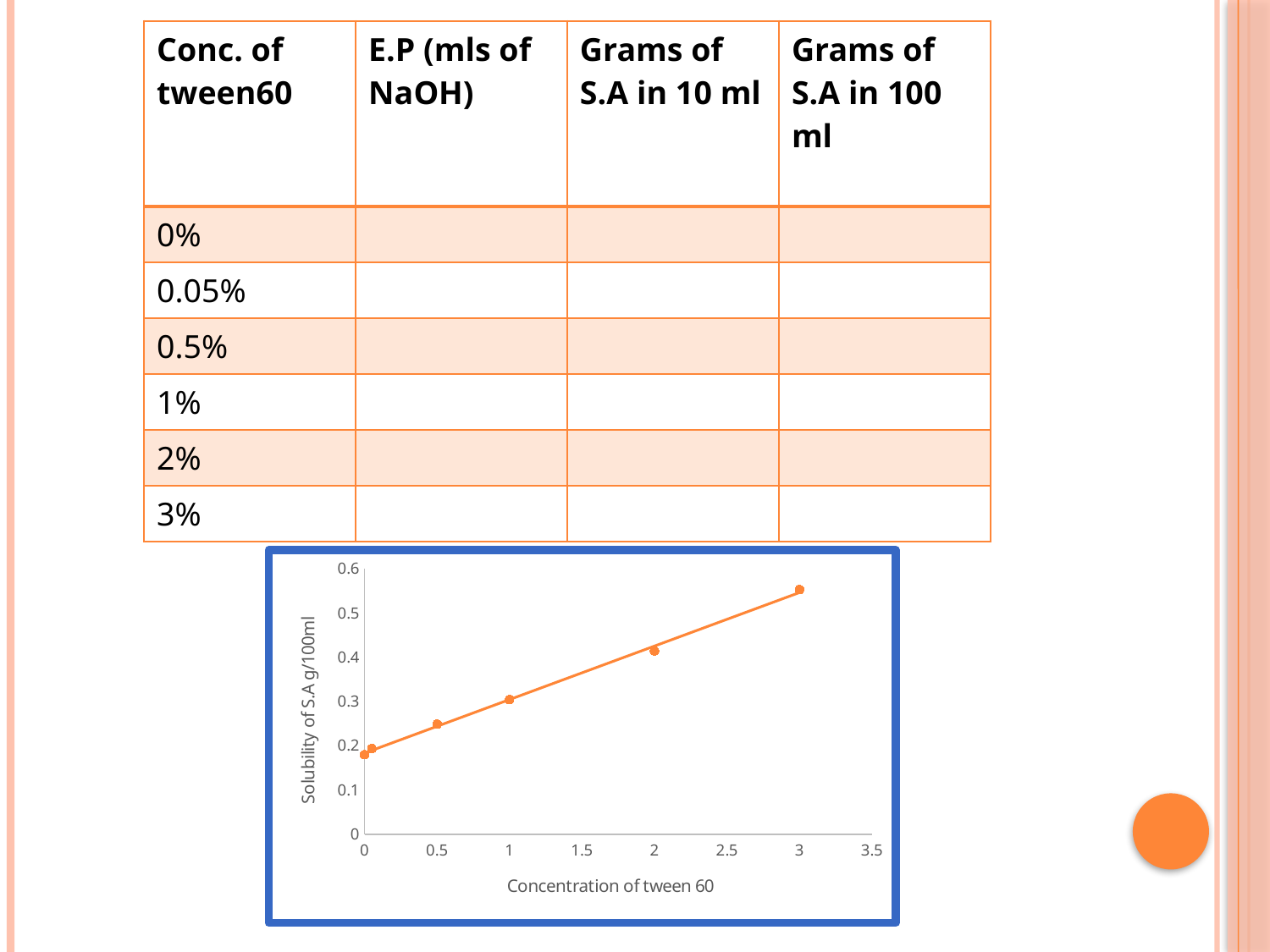
Is the solubility value at concentration 2 greater or less than 0.5? less Is the solubility value at concentration 0.5 greater or less than 0.3? less What is the title of the horizontal axis of the chart? Concentration of tween 60 Is the solubility value at concentration 0 greater or less than 0.2? less How many data points are plotted on the chart? 6 What kind of chart is shown on the slide? scatter chart At which concentration of tween 60 is the plotted solubility lowest? 0 Which has the larger solubility value: concentration 1 or concentration 2? concentration 2 What is the title of the vertical axis of the chart? Solubility of S.A g/100ml Do the plotted solubility values rise or fall as the concentration of tween 60 increases? rise At which concentration of tween 60 is the plotted solubility highest? 3